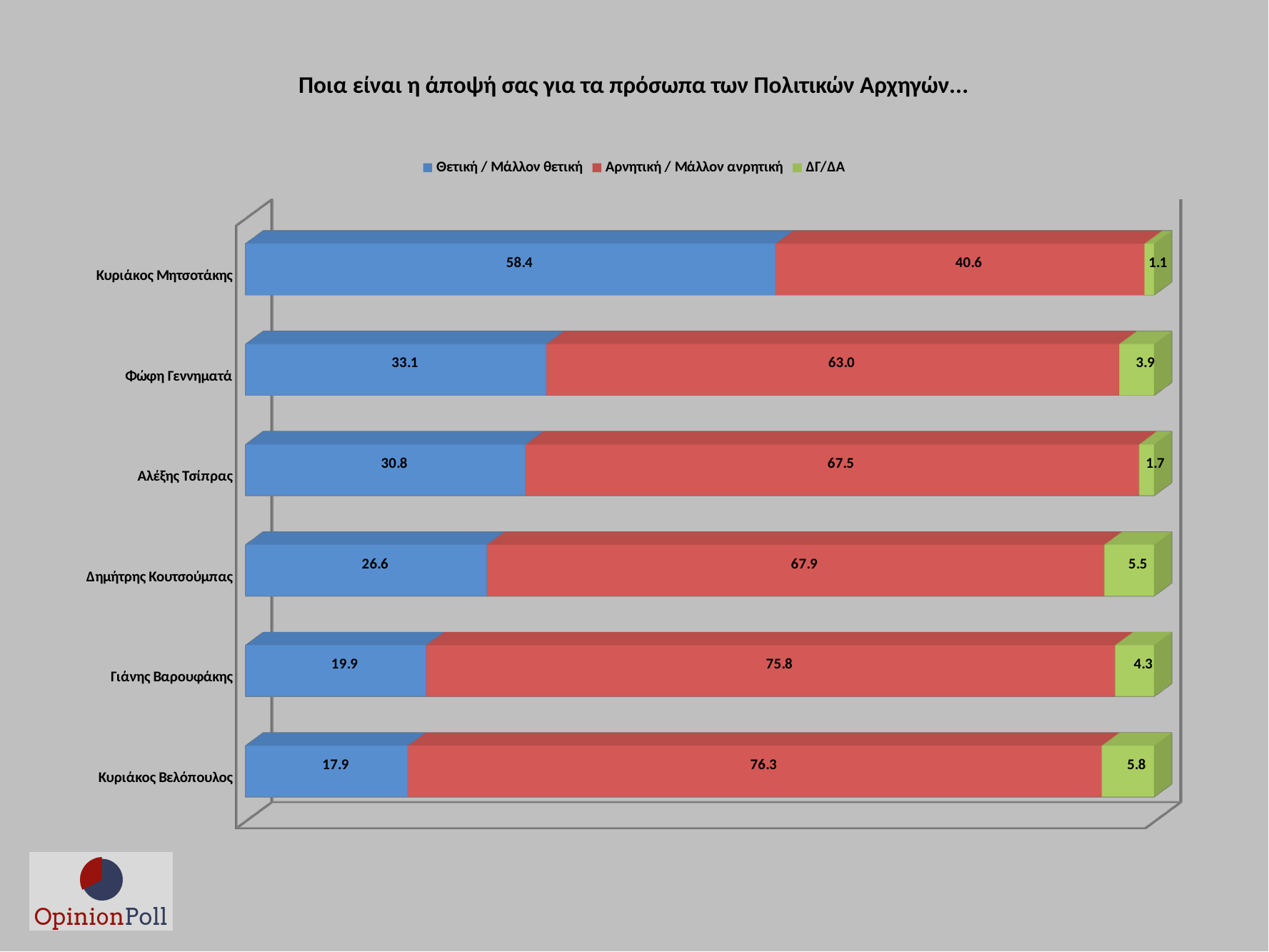
What is the ΔΓ/ΔΑ value for Δημήτρης Κουτσούμπας? 5.5 What is the difference between the Αρνητική / Μάλλον αρνητική values for Κυριάκος Βελόπουλος and Κυριάκος Μητσοτάκης? 35.7 Who has the larger Θετική / Μάλλον θετική value, Φώφη Γεννηματά or Αλέξης Τσίπρας? Φώφη Γεννηματά Which person has the highest Θετική / Μάλλον θετική value? Κυριάκος Μητσοτάκης How many people (categories) are shown in the chart? 6 Which person has the lowest ΔΓ/ΔΑ value? Κυριάκος Μητσοτάκης What is the value of Θετική / Μάλλον θετική for Κυριάκος Μητσοτάκης? 58.4 What kind of chart is shown on the slide? Stacked bar chart How many series does the legend list? 3 What is the total of the stacked bar for Φώφη Γεννηματά? 100.0 What is the value of Αρνητική / Μάλλον αρνητική for Γιάνης Βαρουφάκης? 75.8 Which person has the lowest Θετική / Μάλλον θετική value? Κυριάκος Βελόπουλος